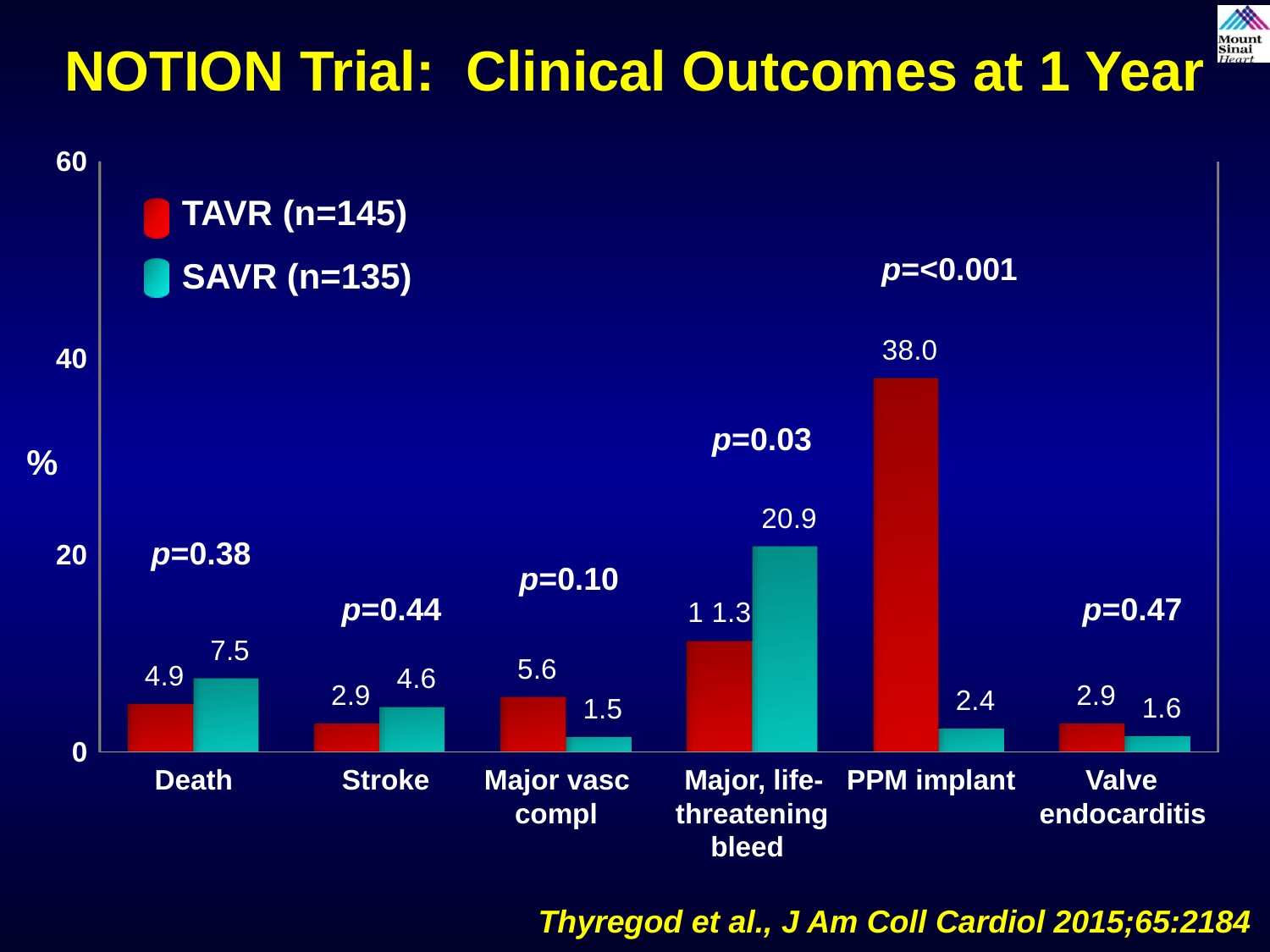
Which category has the lowest SAVR value? Major vasc compl What p-value is shown above the PPM implant bars? p=<0.001 Which is larger for Stroke, the TAVR value or the SAVR value? SAVR What is the SAVR value for Major, life-threatening bleed? 20.9 What is the difference between the TAVR and SAVR values for PPM implant? 35.6 Is the TAVR value for Major, life-threatening bleed greater or less than 20? less What is the TAVR value for Major vasc compl? 5.6 What is the TAVR value for PPM implant? 38.0 What is the SAVR value for Death? 7.5 How many outcome categories are shown on the x axis? 6 Which category has the highest TAVR value? PPM implant How many series does the legend list? 2